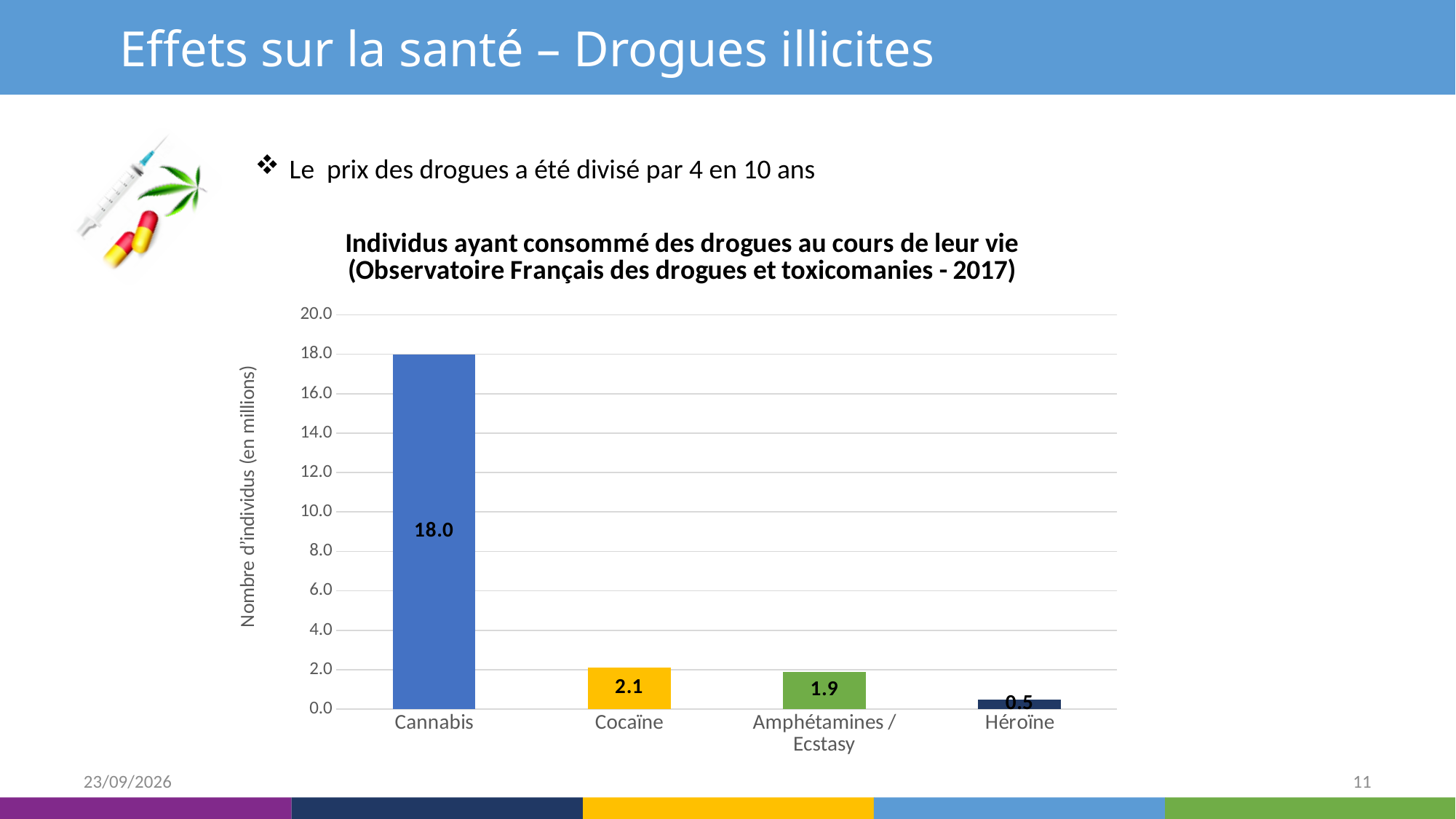
Which is larger, the value for Cannabis or the value for Héroïne? Cannabis What kind of chart is shown on the slide? Bar chart How many categories are shown on the x axis? 4 What is the label of the vertical axis? Nombre d'individus (en millions) Which category has the highest value? Cannabis What is the difference between the values for Cannabis and Cocaïne? 15.9 What is the value for Cannabis? 18.0 Which category has the lowest value? Héroïne What is the difference between the values for Cocaïne and Héroïne? 1.6 What is the value for Héroïne? 0.5 What is the value for Cocaïne? 2.1 What is the value for Amphétamines / Ecstasy? 1.9